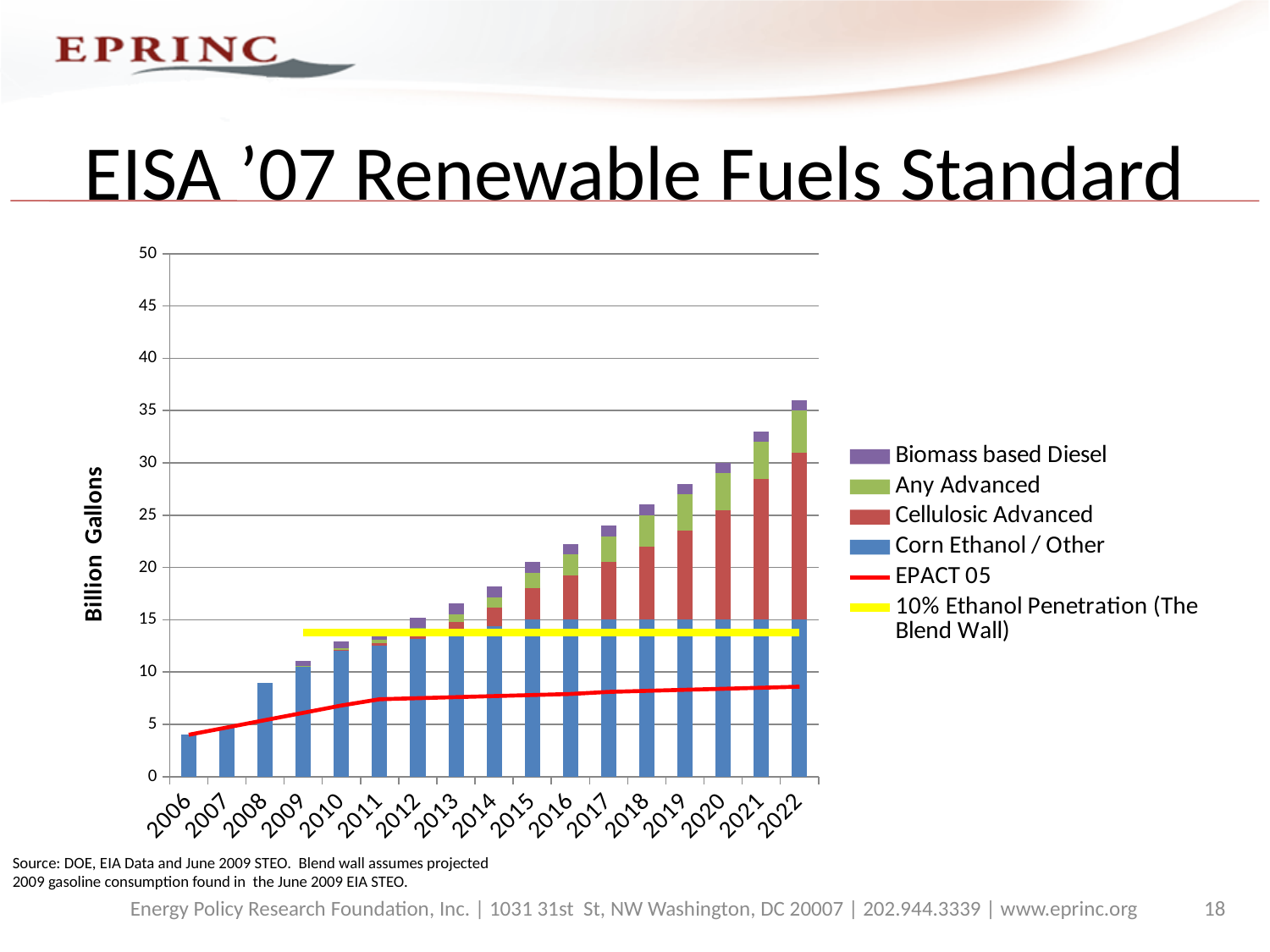
Is the total stacked bar value for 2015 greater or less than 15? greater How many years are shown along the x axis of the chart? 17 Which year has the shortest stacked bar? 2006 Do the total stacked bar values rise or fall from 2006 to 2022? rise Is the total bar value for 2006 greater or less than 5? less What is the label on the chart's vertical axis? Billion Gallons Which year has a taller stacked bar, 2015 or 2020? 2020 Which year has the tallest stacked bar? 2022 Is the total bar value for 2010 greater or less than 15? less What kind of chart is shown on the slide? Stacked bar chart with line series How many series does the chart's legend list? 6